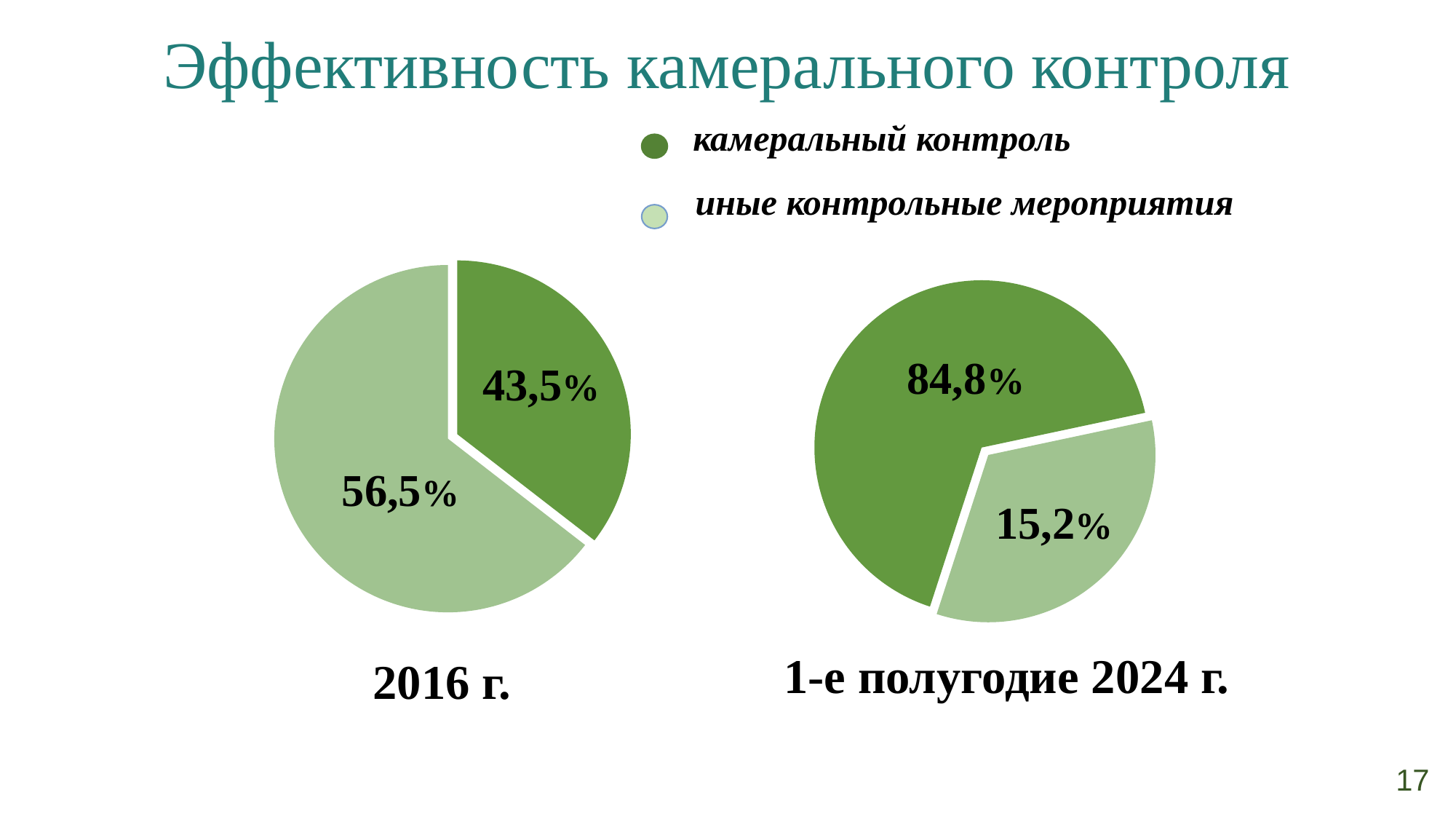
In the 2016 г. pie chart, what is the difference between the shares of иные контрольные мероприятия and камеральный контроль? 13% What is the title of the slide? Эффективность камерального контроля What type of chart is used on this slide? Pie chart In the 1-е полугодие 2024 г. pie chart, which category has the smaller share? иные контрольные мероприятия In the 2016 г. pie chart, which category has the larger share? иные контрольные мероприятия In the 2016 г. pie chart, what share is shown for иные контрольные мероприятия? 56,5% In the 1-е полугодие 2024 г. pie chart, what share is shown for камеральный контроль? 84,8% Is the share of камеральный контроль larger in the 2016 г. chart or in the 1-е полугодие 2024 г. chart? 1-е полугодие 2024 г. In the 1-е полугодие 2024 г. pie chart, what is the difference between the shares of камеральный контроль and иные контрольные мероприятия? 69,6% In the 1-е полугодие 2024 г. pie chart, what share is shown for иные контрольные мероприятия? 15,2% How many categories does the legend list? 2 In the 2016 г. pie chart, what share is shown for камеральный контроль? 43,5%